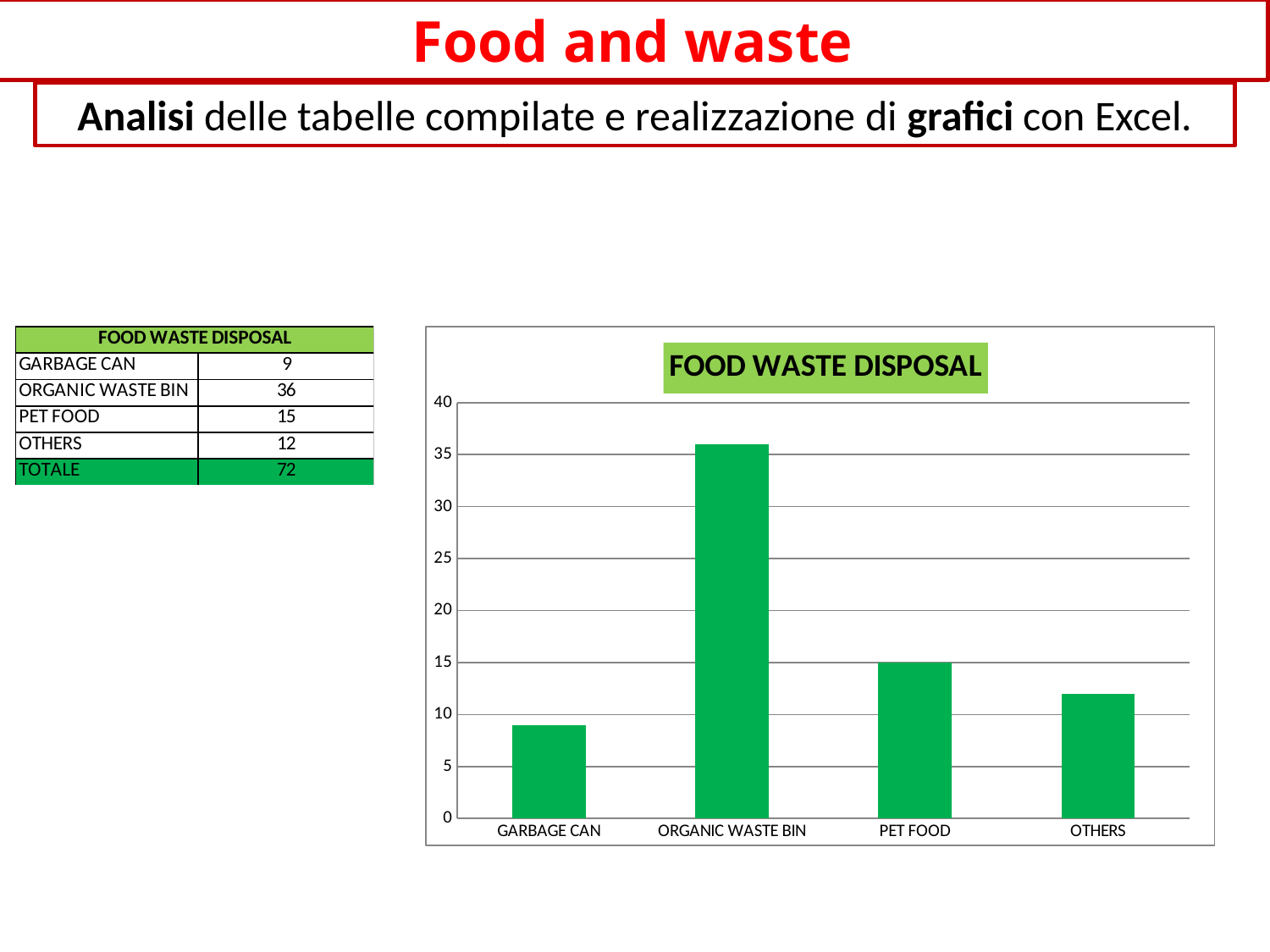
Which is larger, the value for PET FOOD or the value for OTHERS? PET FOOD What is the value for ORGANIC WASTE BIN? 36 What type of chart is shown on the slide? bar chart What is the difference between the values for ORGANIC WASTE BIN and PET FOOD? 21 What is the value for PET FOOD? 15 Which category has the lowest value in the chart? GARBAGE CAN What is the value for OTHERS? 12 Is the value for GARBAGE CAN greater or less than 10? less What is the value for GARBAGE CAN? 9 Which category has the highest value in the chart? ORGANIC WASTE BIN How many categories are shown on the x axis of the chart? 4 What is the title of the chart? FOOD WASTE DISPOSAL